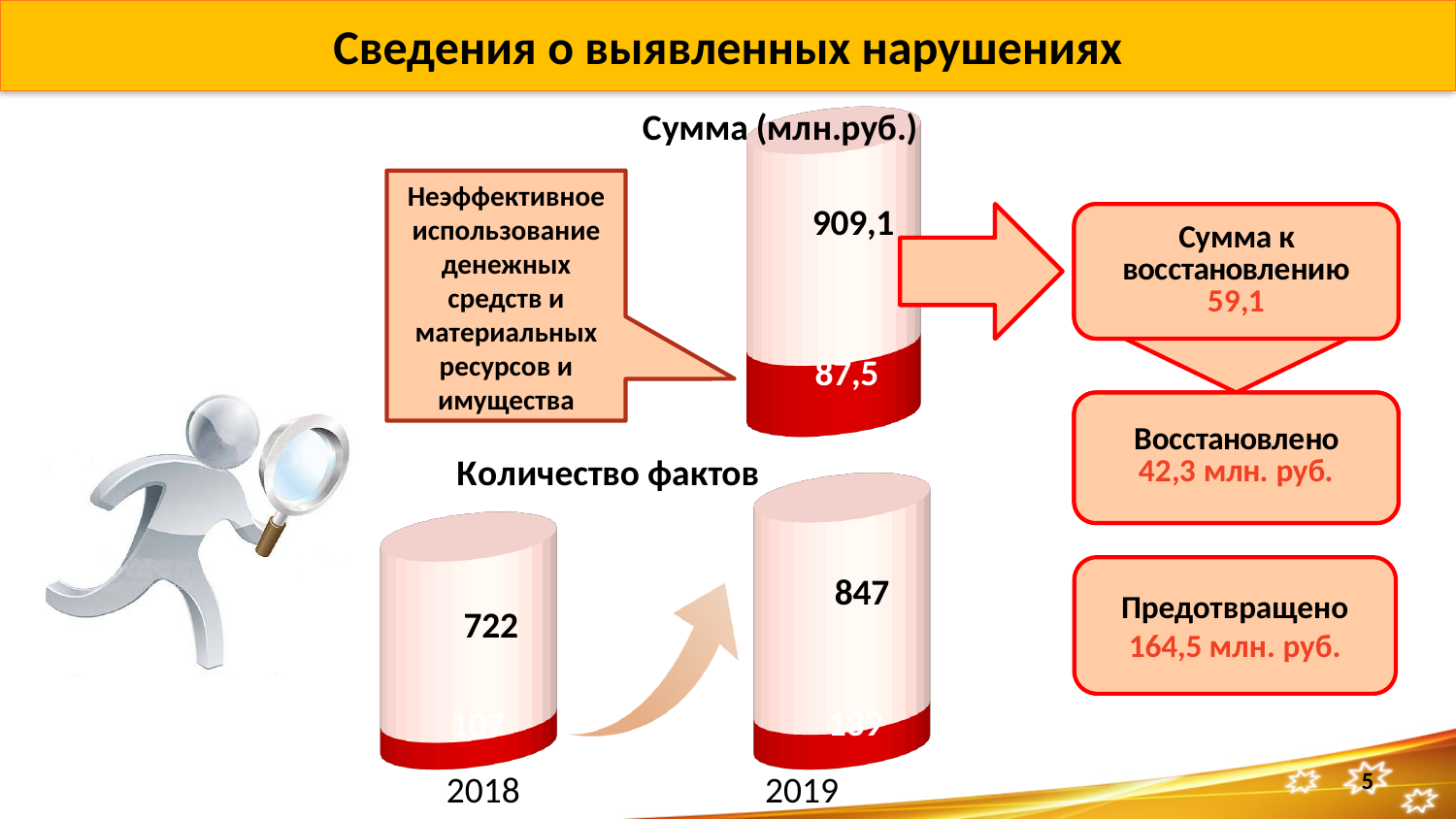
In the 'Сумма (млн.руб.)' chart, what is the total of the two labelled segments (909,1 and 87,5)? 996,6 In the 'Количество фактов' chart, which year has the larger light-segment value, 2018 or 2019? 2019 In the 'Сумма (млн.руб.)' chart, what value is printed on the red segment at the bottom of the bar? 87,5 In the 'Количество фактов' chart, what value is printed on the large light segment of the 2018 bar? 722 What is the title of the chart at the top of the slide? Сумма (млн.руб.) In the 'Количество фактов' chart, what value is printed on the large light segment of the 2019 bar? 847 In the 'Количество фактов' chart, what is the difference between the light-segment values for 2019 (847) and 2018 (722)? 125 In the 'Сумма (млн.руб.)' chart, which segment is larger, the light one or the red one? the light one (909,1) What kind of chart is the 'Количество фактов' chart? bar chart In the 'Количество фактов' chart, how many years are shown on the x axis? 2 In the 'Количество фактов' chart, do the values rise or fall from 2018 to 2019? rise In the 'Сумма (млн.руб.)' chart, what value is printed on the large light segment of the bar? 909,1